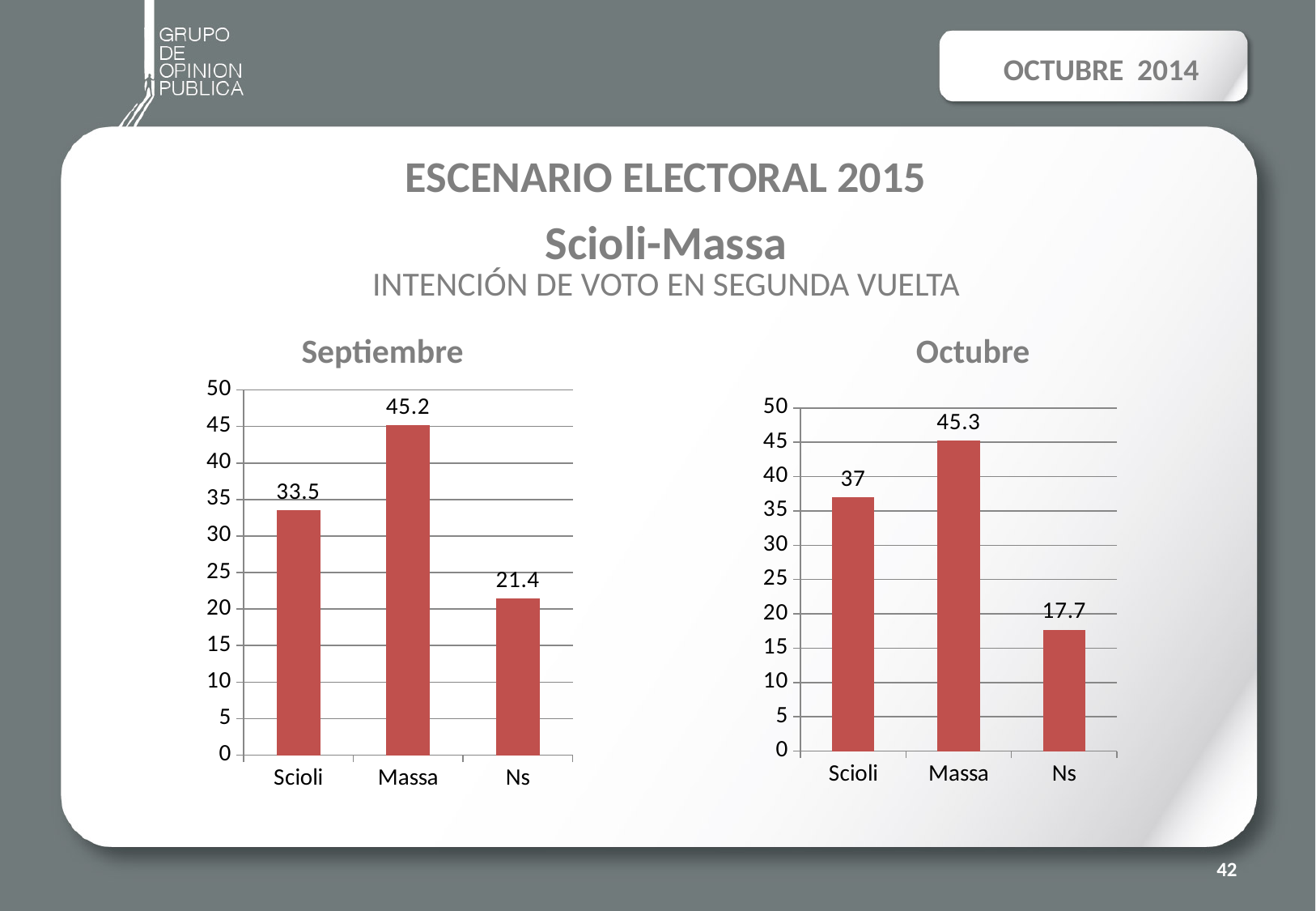
In the Octubre chart, what is the value for Scioli? 37 In the Septiembre chart, which category has the highest value? Massa In the Septiembre chart, what is the difference between the values for Massa and Scioli? 11.7 How many categories are shown in the Octubre chart? 3 Is the value for Scioli larger in the Septiembre chart or in the Octubre chart? Octubre In the Septiembre chart, what is the value for Massa? 45.2 In the Octubre chart, what is the difference between the values for Scioli and Ns? 19.3 In the Octubre chart, which category has the lowest value? Ns What is the title of the chart on the right side of the slide? Octubre In the Octubre chart, what is the value for Ns? 17.7 In the Septiembre chart, is the value for Ns greater or less than 25? less What kind of chart is the Septiembre chart? bar chart